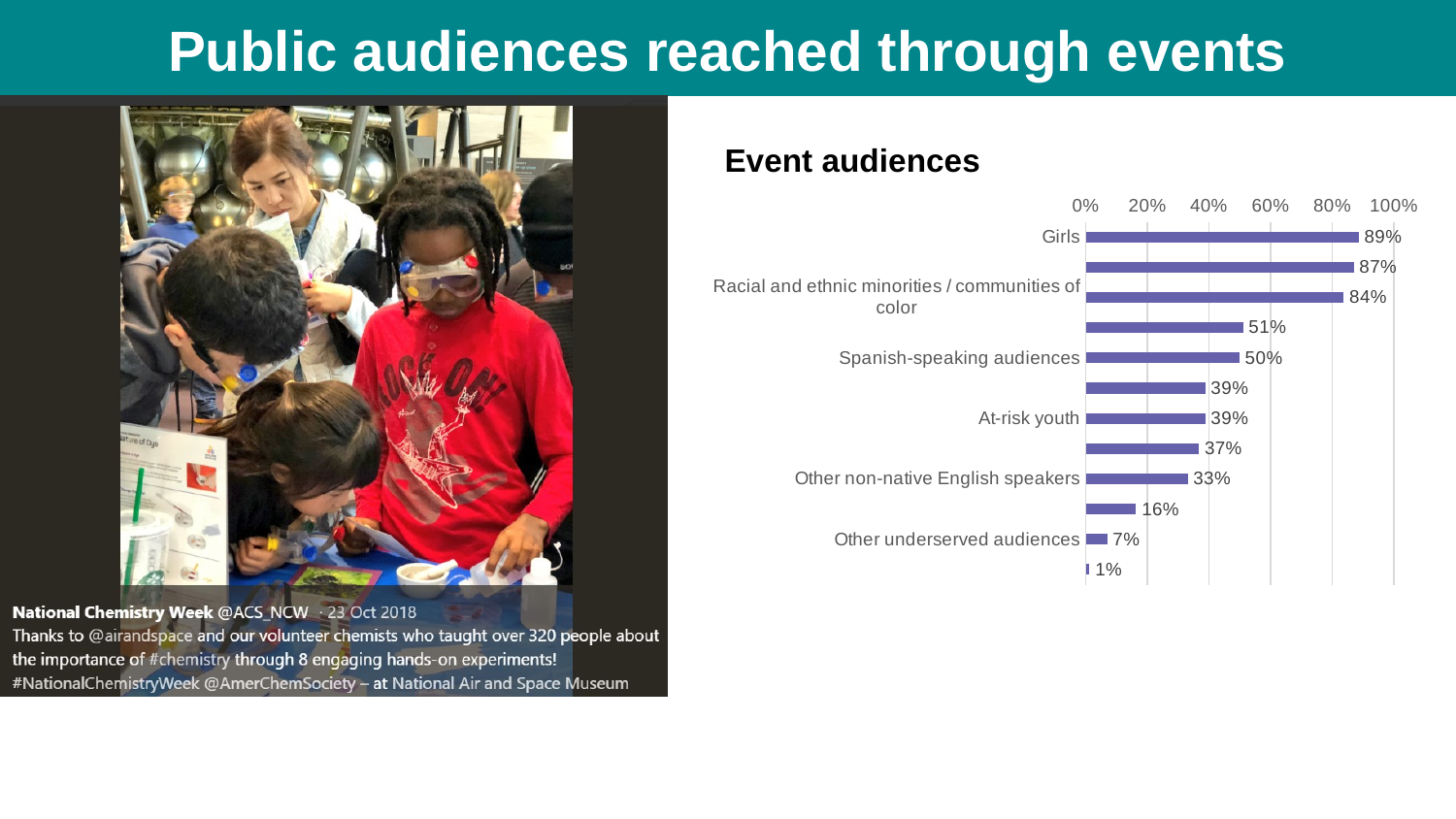
What is the title of the chart on the slide? Event audiences What value is shown for Racial and ethnic minorities / communities of color? 84% What percentage is shown for Spanish-speaking audiences? 50% Which labeled category has the highest value in the Event audiences chart? Girls What type of chart is shown under the heading "Event audiences"? Bar chart What value does the chart show for At-risk youth? 39% What percentage is shown for Girls in the Event audiences chart? 89% What percentage is shown for Other non-native English speakers? 33% What value is shown for Other underserved audiences? 7% Which is larger, the value for At-risk youth or the value for Other non-native English speakers? At-risk youth What is the smallest value shown on any bar in the Event audiences chart? 1% What is the difference between the values for Girls and Spanish-speaking audiences? 39 percentage points